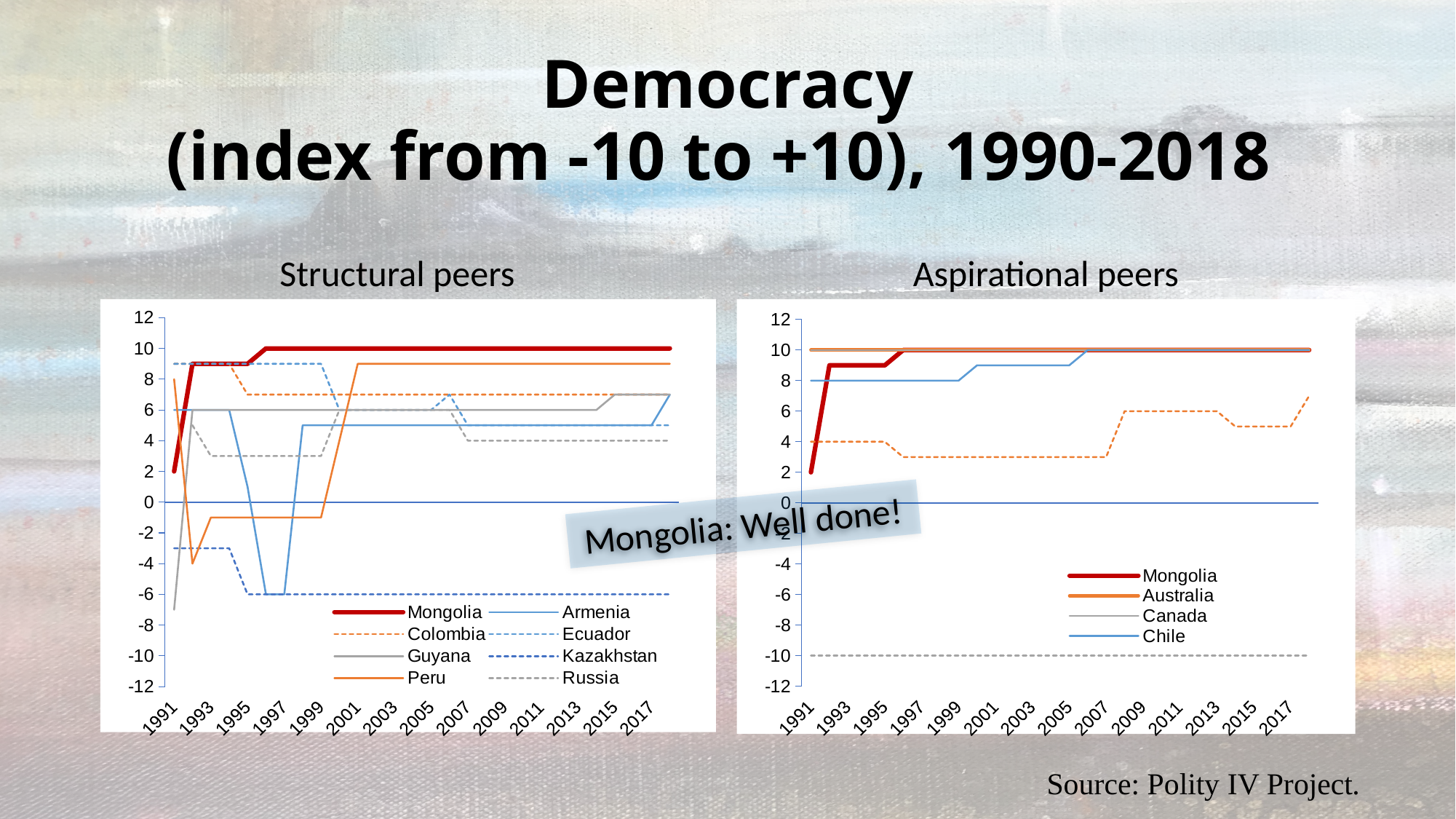
In the 'Structural peers' chart, what is the value for Russia in 2017? 4 How many series does the legend of the 'Structural peers' chart list? 8 How many series does the legend of the 'Aspirational peers' chart list? 4 In the 'Structural peers' chart, which is larger in 2017, Mongolia or Colombia? Mongolia In the 'Aspirational peers' chart, does the Mongolia line rise or fall from 1991 to 2017? rise In the 'Structural peers' chart, is the value for Peru in 2017 greater or less than 8? greater What source is cited for the charts on the slide? Polity IV Project In the 'Structural peers' chart, which series has the lowest value in 2017? Kazakhstan What kind of chart is the 'Structural peers' chart? line chart In the 'Structural peers' chart, what is the value for Mongolia in 2017? 10 In the 'Aspirational peers' chart, what is the value for Mongolia in 1991? 2 In the 'Structural peers' chart, what is the value for Kazakhstan in 2017? -6